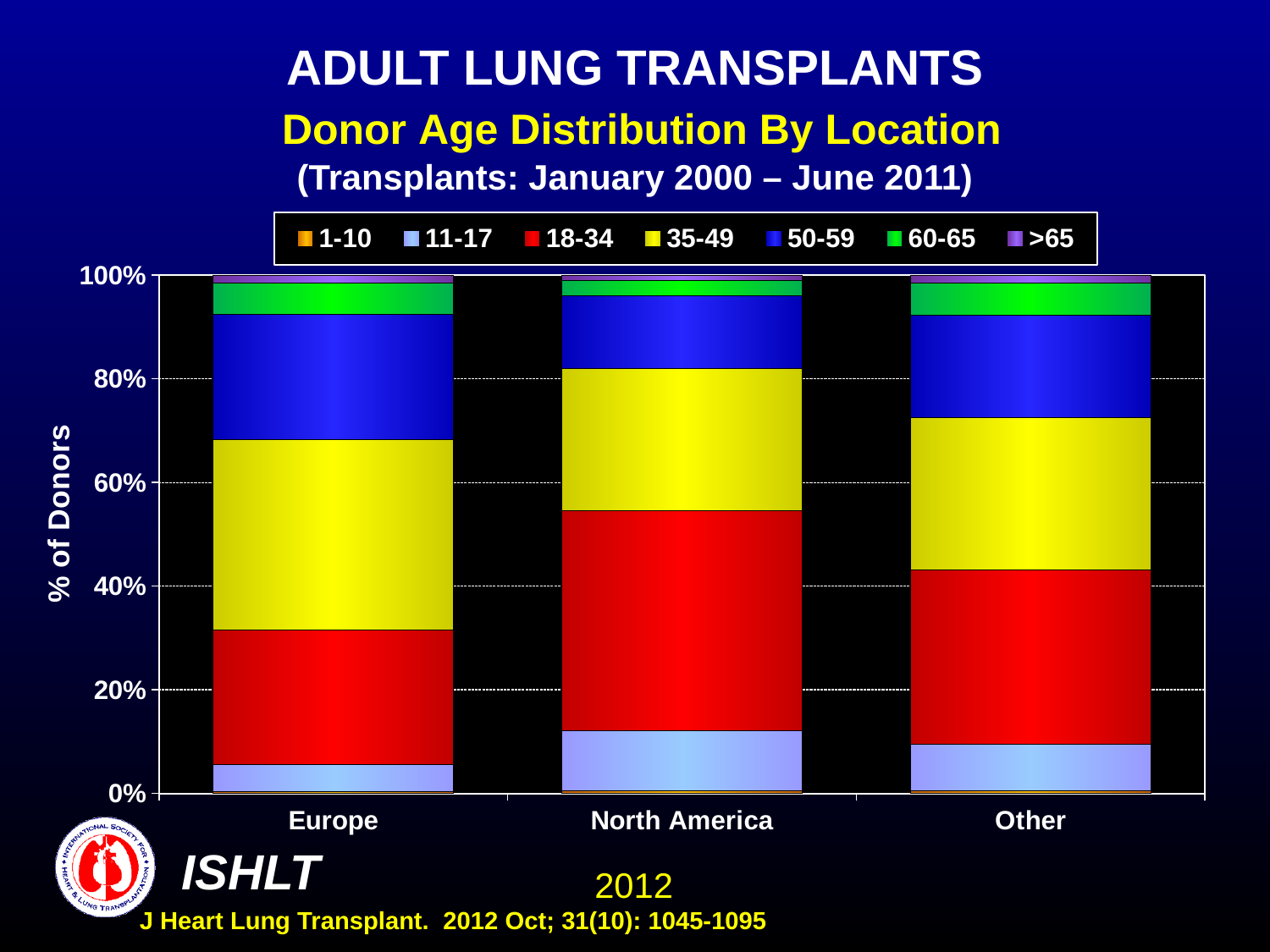
Which location has the largest 35-49 donor segment? Europe Is the 50-59 donor segment larger for Europe or for North America? Europe Which location has the smallest 11-17 donor segment? Europe What is the label of the y axis? % of Donors Is the 11-17 donor share for Europe greater or less than 20%? less What does each stacked bar total? 100% How many locations are shown on the x axis of the chart? 3 Which location has the largest 18-34 donor segment? North America Which age group is shown in red in the legend? 18-34 What kind of chart is shown on the slide? Stacked bar chart Is the 18-34 donor share for North America greater or less than 20%? greater How many donor age groups does the legend list? 7